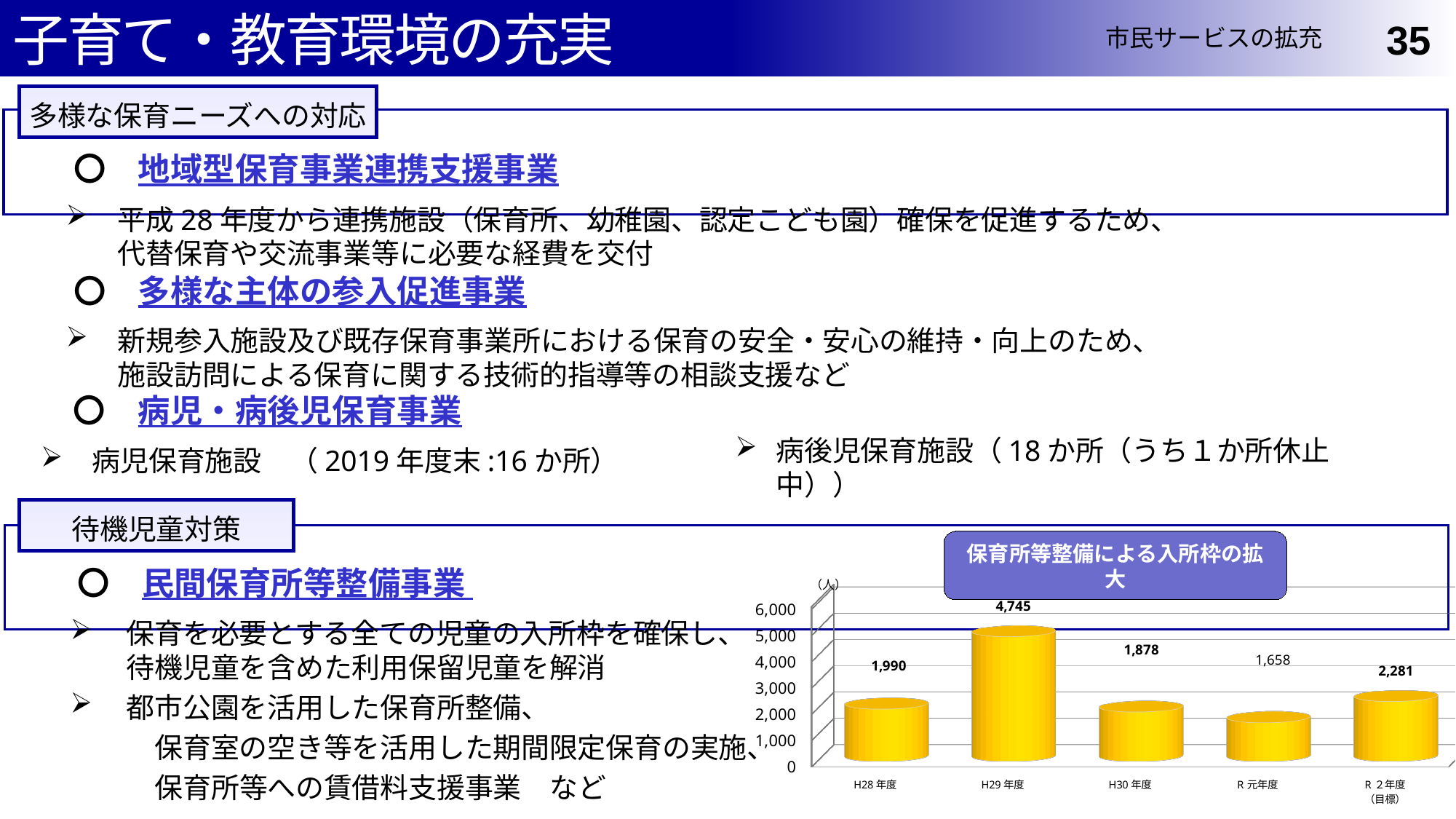
What is the difference between the values for H29年度 and H28年度? 2,755 Which year has the lowest value in the chart? R元年度 How many years (categories) are shown on the x axis of the chart? 5 What is the value for H29年度 in the chart? 4,745 Which is larger, the value for H28年度 or the value for H30年度? H28年度 What is the difference between the values for H30年度 and R元年度? 220 What is the value for H28年度 in the chart? 1,990 Which year has the highest value in the chart? H29年度 What is the value for R元年度 in the chart? 1,658 What kind of chart is shown on the slide? Bar chart What is the target value shown for R２年度（目標） in the chart? 2,281 What is the title of the chart on the slide? 保育所等整備による入所枠の拡大